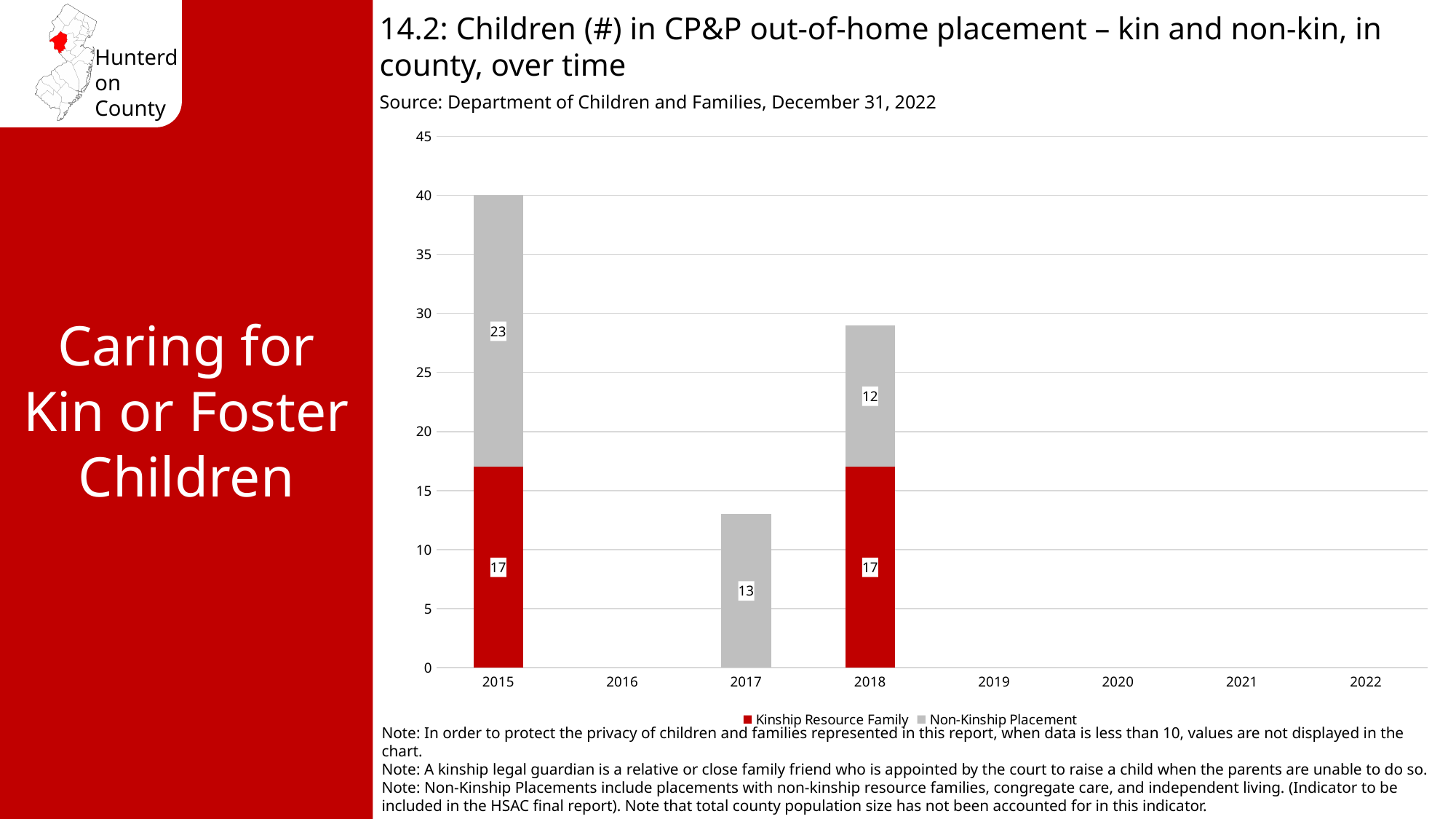
Which is larger in 2018, Kinship Resource Family or Non-Kinship Placement? Kinship Resource Family What is the difference between the Non-Kinship Placement values for 2015 and 2018? 11 What is the value for Non-Kinship Placement in 2015? 23 Which year has the highest total number of children in out-of-home placement? 2015 How many series does the legend list? 2 What kind of chart is shown on the slide? Stacked bar chart What is the value for Non-Kinship Placement in 2018? 12 What is the total of the stacked bar for 2018? 29 What is the total of the stacked bar for 2015? 40 Which colour represents Kinship Resource Family in the chart? Red What is the value for Non-Kinship Placement in 2017? 13 What is the value for Kinship Resource Family in 2015? 17